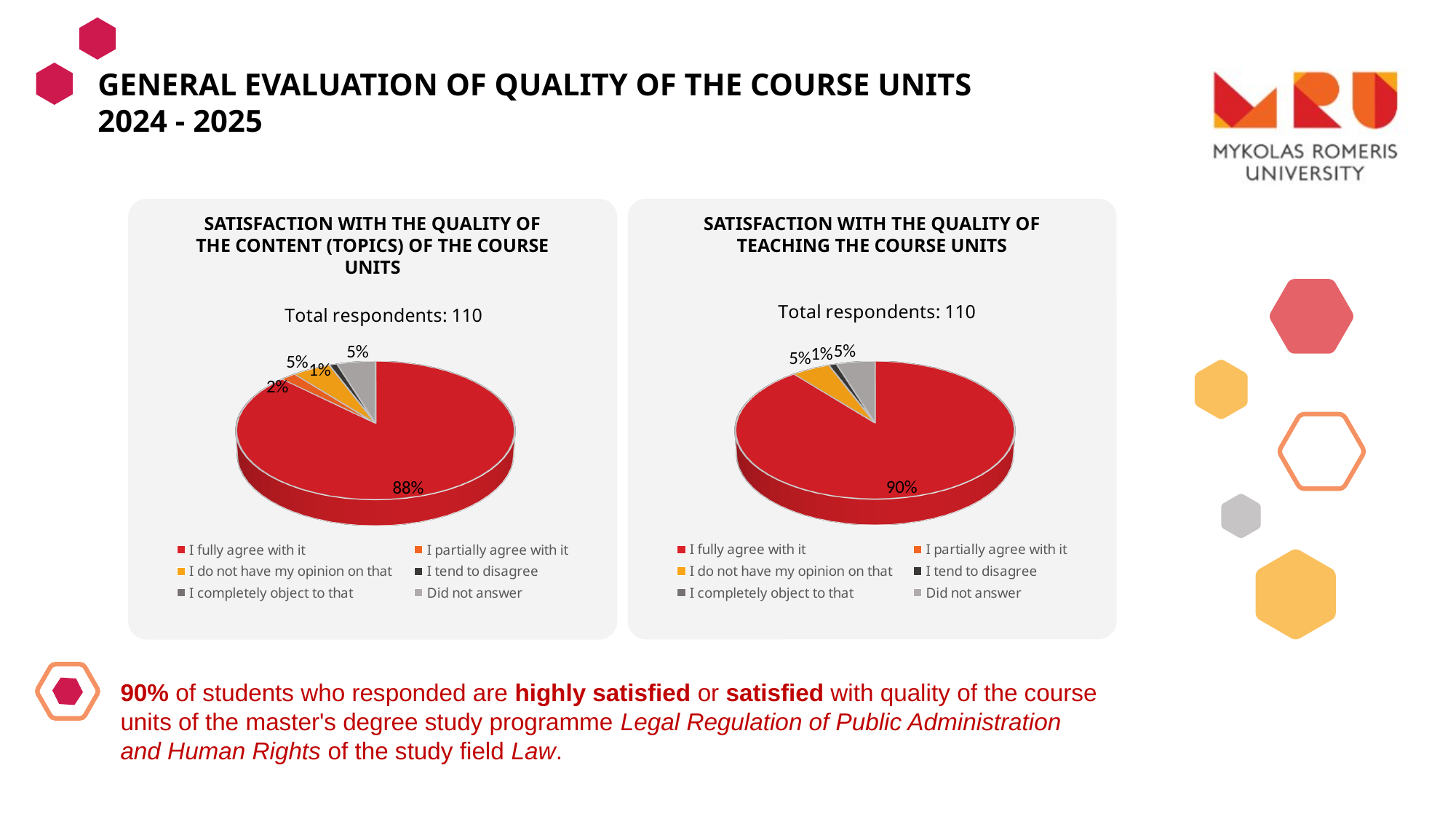
What is the difference between the 'I fully agree with it' share in the teaching chart and the 'I fully agree with it' share in the content chart? 2% In the 'Satisfaction with the quality of teaching the course units' chart, what share of respondents 'Did not answer'? 5% In the 'Satisfaction with the quality of the content (topics) of the course units' chart, what share of respondents chose 'I tend to disagree'? 1% What type of chart is used in the 'Satisfaction with the quality of teaching the course units' panel? Pie chart In the 'Satisfaction with the quality of teaching the course units' chart, what share of respondents chose 'I fully agree with it'? 90% In the 'Satisfaction with the quality of the content (topics) of the course units' chart, what share of respondents chose 'I partially agree with it'? 2% In the 'Satisfaction with the quality of teaching the course units' chart, what share of respondents chose 'I do not have my opinion on that'? 5% In the 'Satisfaction with the quality of the content (topics) of the course units' chart, what share of respondents chose 'I fully agree with it'? 88% How many entries does the legend of the 'Satisfaction with the quality of the content (topics) of the course units' chart list? 6 Which chart has the larger 'I fully agree with it' share: the content (topics) chart or the teaching chart? The teaching chart In the 'Satisfaction with the quality of teaching the course units' chart, which response has the smallest share? I tend to disagree In the 'Satisfaction with the quality of the content (topics) of the course units' chart, which response has the largest share? I fully agree with it